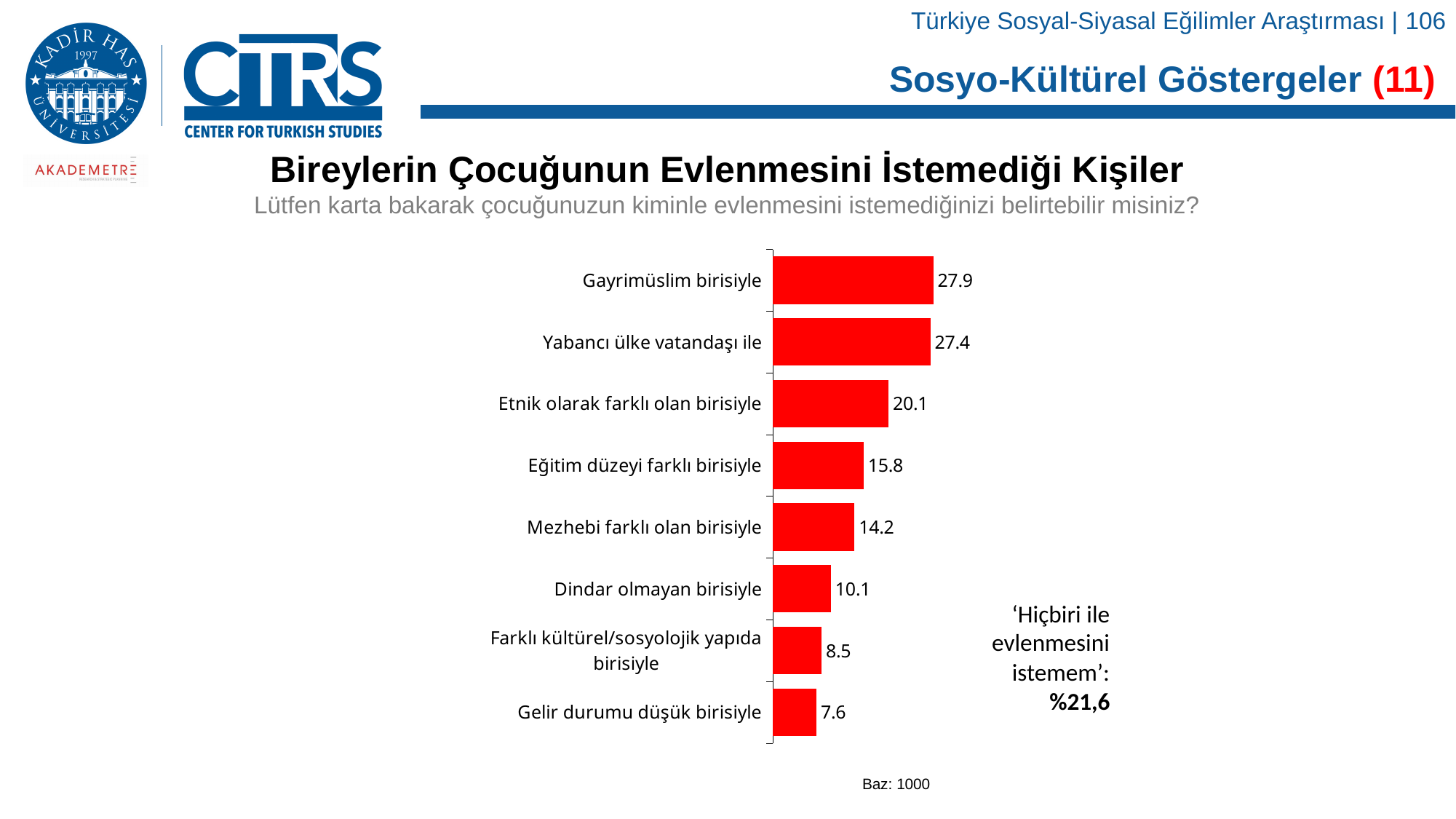
What is the value for 'Gelir durumu düşük birisiyle'? 7.6 What kind of chart is shown on the slide? Bar chart What is the difference between the values for 'Gayrimüslim birisiyle' and 'Yabancı ülke vatandaşı ile'? 0.5 Which category has the highest value? Gayrimüslim birisiyle What is the difference between the values for 'Etnik olarak farklı olan birisiyle' and 'Eğitim düzeyi farklı birisiyle'? 4.3 What percentage is given for 'Hiçbiri ile evlenmesini istemem' in the text next to the chart? %21,6 What is the value for 'Gayrimüslim birisiyle'? 27.9 What is the value for 'Etnik olarak farklı olan birisiyle'? 20.1 How many categories are shown in the chart? 8 Which is larger: the value for 'Mezhebi farklı olan birisiyle' or 'Dindar olmayan birisiyle'? Mezhebi farklı olan birisiyle Which category has the lowest value? Gelir durumu düşük birisiyle What is the value for 'Dindar olmayan birisiyle'? 10.1